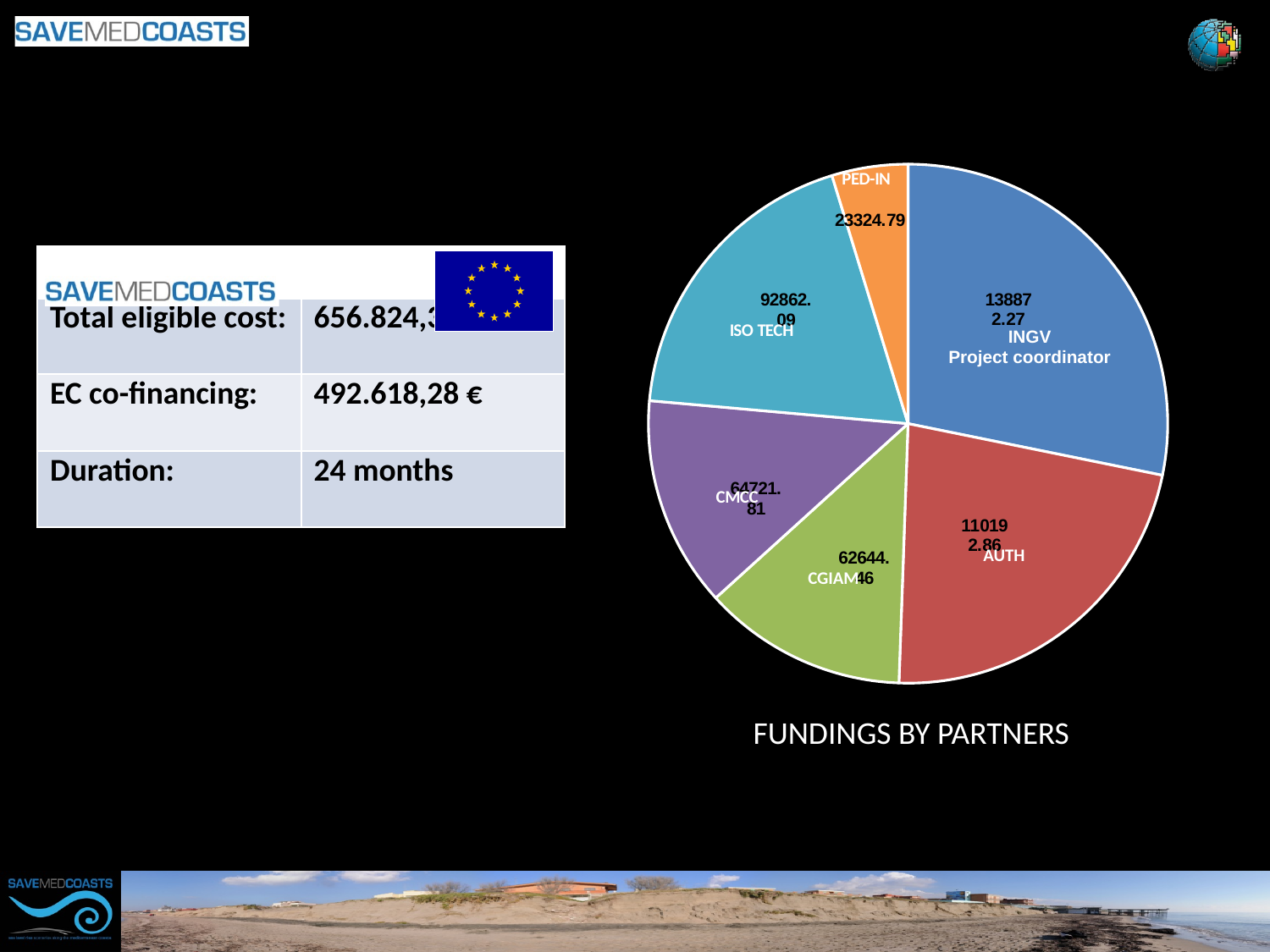
What is the title of the chart? FUNDINGS BY PARTNERS Which partner receives the largest share of funding in the pie chart? INGV What is the funding value shown for AUTH? 110192.86 Which partner is labelled as Project coordinator in the pie chart? INGV What is the funding value shown for PED-IN? 23324.79 What is the funding value shown for ISO TECH? 92862.09 How many partner slices does the pie chart have? 6 What is the funding value shown for CMCC? 64721.81 What type of chart is shown on the slide? pie chart What is the difference between the funding values of INGV and AUTH? 28679.41 Which partner receives the smallest share of funding in the pie chart? PED-IN Which partner has the larger funding value, CMCC or CGIAM? CMCC